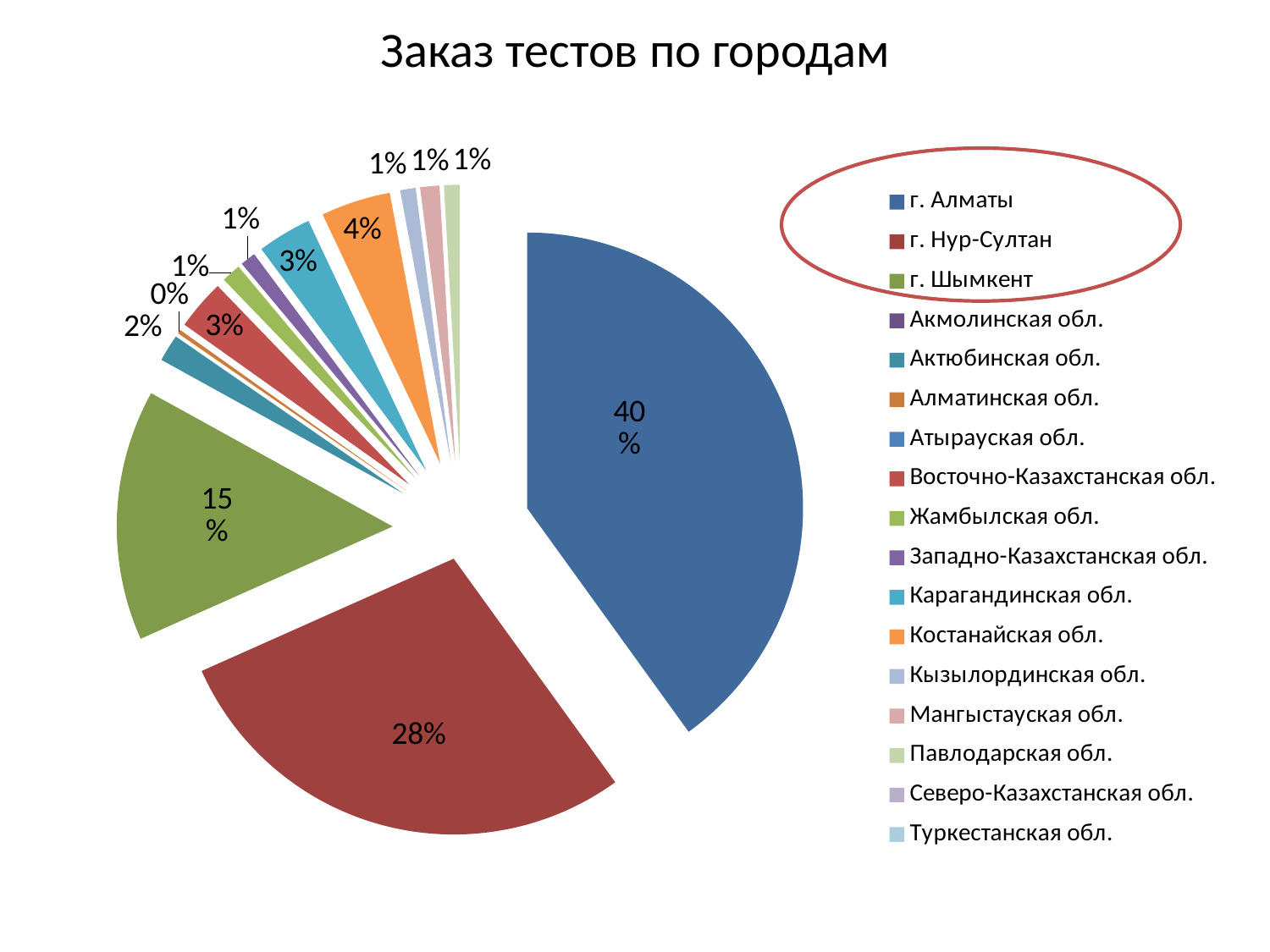
What is the difference between the shares of г. Нур-Султан and г. Шымкент? 13% What share of the pie does г. Алматы have? 40% What type of chart is shown on the slide? Pie chart Which legend entries are circled in red on the slide? г. Алматы, г. Нур-Султан, г. Шымкент What percentage is shown for г. Нур-Султан? 28% How many categories are listed in the legend? 17 Which category has the largest slice of the pie? г. Алматы Which has the larger share, г. Шымкент or г. Нур-Султан? г. Нур-Султан What percentage is shown for г. Шымкент? 15% What is the combined share of г. Алматы, г. Нур-Султан and г. Шымкент? 83% What is the title of the chart? Заказ тестов по городам How many percentage points larger is the share of г. Алматы than that of г. Нур-Султан? 12%